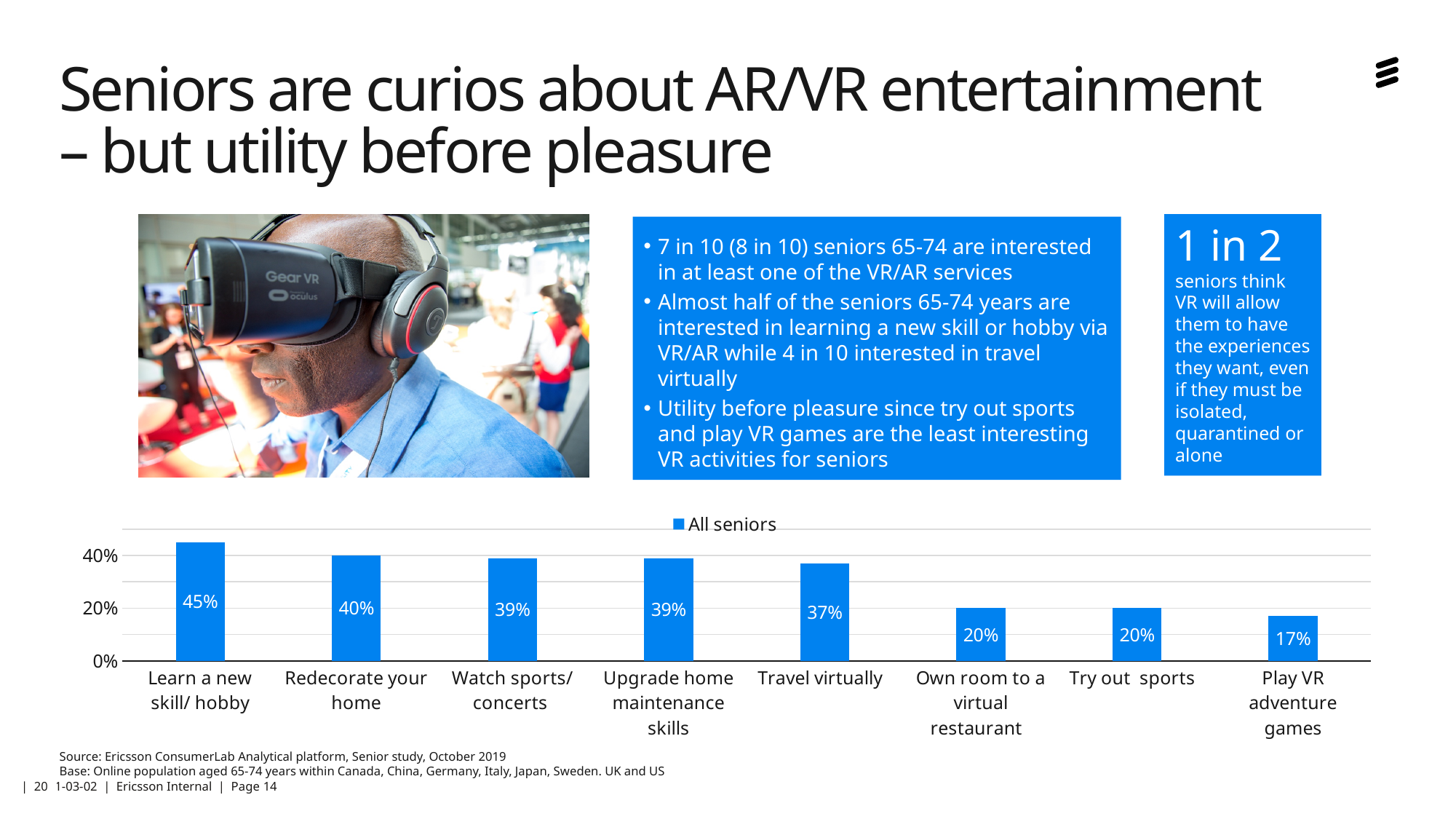
What kind of chart is shown on the slide? bar chart What is the difference between the values for Learn a new skill/ hobby and Play VR adventure games? 28% How many categories are shown on the x axis? 8 Which is larger, the value for Travel virtually or the value for Try out sports? Travel virtually What is the value for Play VR adventure games? 17% Which category has the lowest value? Play VR adventure games Which category has the highest value? Learn a new skill/ hobby What is the value for Travel virtually? 37% What is the difference between the values for Redecorate your home and Own room to a virtual restaurant? 20% Is the value for Upgrade home maintenance skills greater or less than 20%? greater What series does the legend list? All seniors What is the value for Learn a new skill/ hobby? 45%